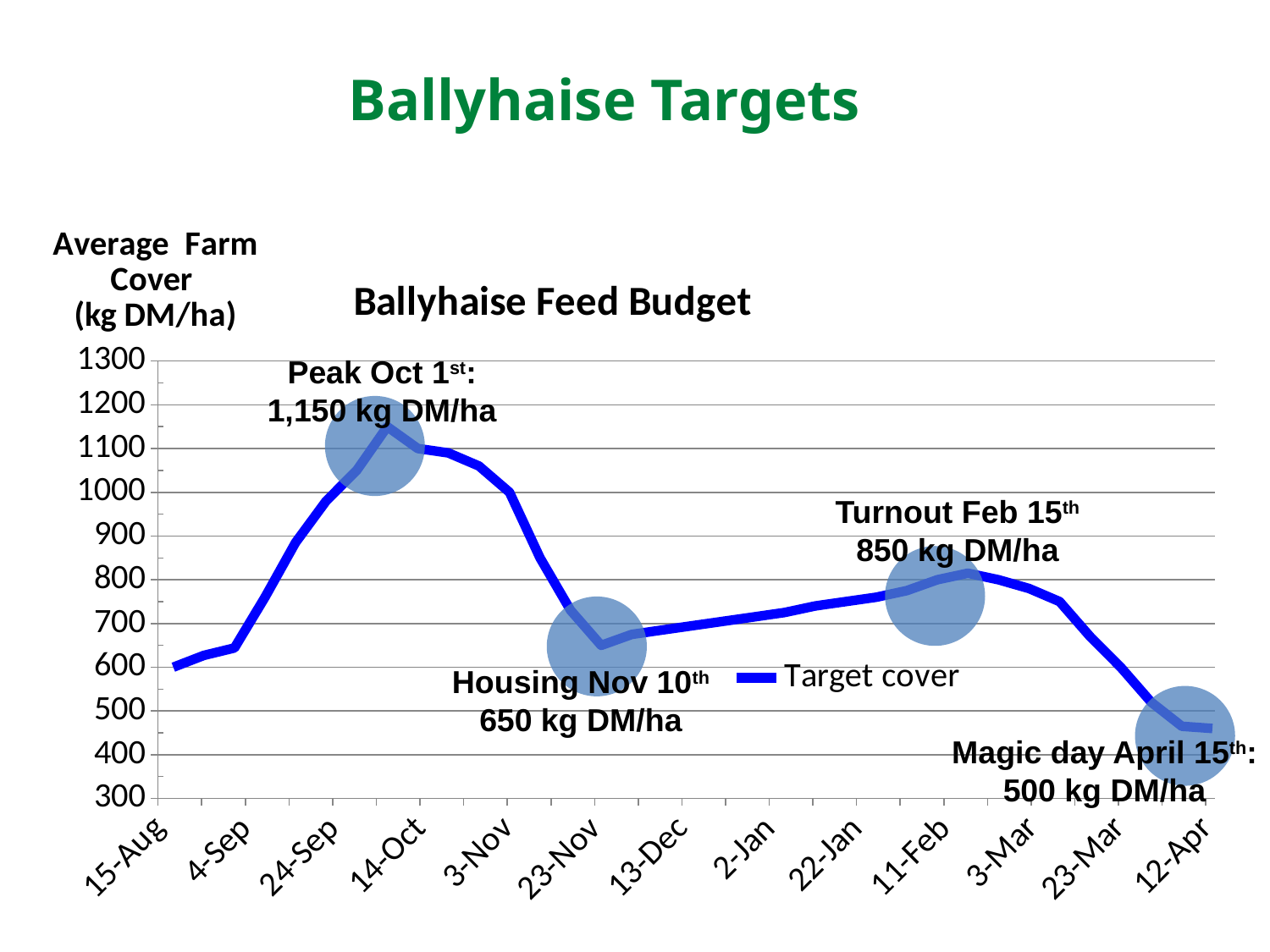
Is the target cover at 22-Jan greater or less than 700? greater According to the annotation, what is the target cover at the peak on Oct 1st? 1,150 kg DM/ha According to the annotation, what is the target cover at turnout on Feb 15th? 850 kg DM/ha What is the difference between the annotated peak cover on Oct 1st and the annotated housing cover on Nov 10th? 500 kg DM/ha Is the target cover at 12-Apr greater or less than 500? less Does the target cover rise or fall between 11-Feb and 12-Apr? fall What type of chart is shown on the slide? line chart What is the title of the chart? Ballyhaise Feed Budget According to the annotation, what is the target cover at housing on Nov 10th? 650 kg DM/ha What is the name of the series shown in the legend? Target cover According to the annotation, what is the target cover on magic day, April 15th? 500 kg DM/ha How many series does the legend list? 1